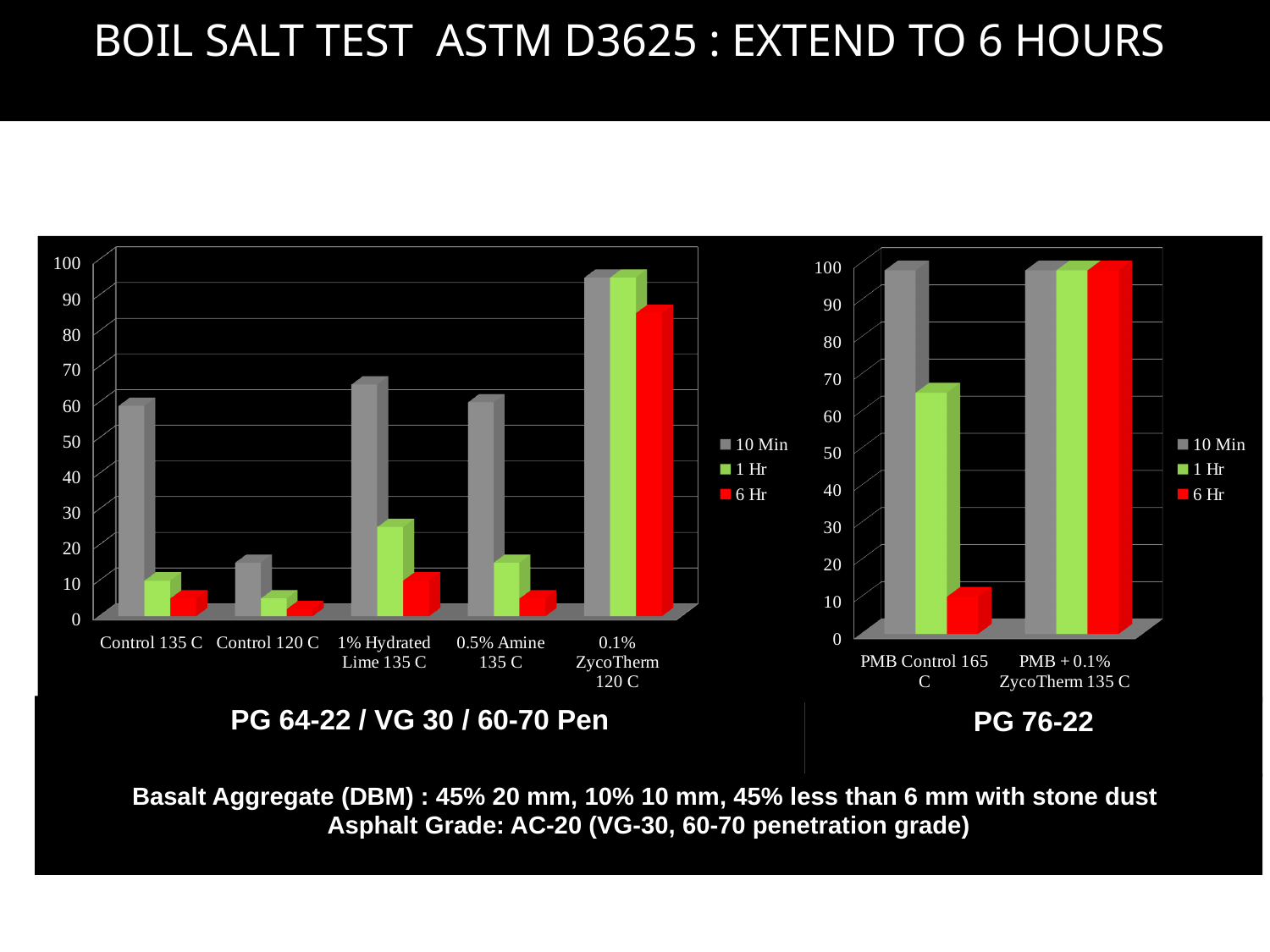
In the right chart (PG 76-22), which category has the larger 6 Hr value, PMB Control 165 C or PMB + 0.1% ZycoTherm 135 C? PMB + 0.1% ZycoTherm 135 C In the left chart (PG 64-22 / VG 30 / 60-70 Pen), is the 10 Min value for Control 135 C greater or less than 50? greater In the left chart (PG 64-22 / VG 30 / 60-70 Pen), which category has the lowest 10 Min value? Control 120 C In the left chart (PG 64-22 / VG 30 / 60-70 Pen), is the 6 Hr value for 1% Hydrated Lime 135 C greater or less than 20? less What kind of chart is the left chart (PG 64-22 / VG 30 / 60-70 Pen)? bar chart What are the legend entries of the right chart (PG 76-22)? 10 Min, 1 Hr, 6 Hr In the left chart (PG 64-22 / VG 30 / 60-70 Pen), which category has the highest 6 Hr value? 0.1% ZycoTherm 120 C In the right chart (PG 76-22), is the 1 Hr value for PMB Control 165 C greater or less than 50? greater How many series does the legend of the left chart (PG 64-22 / VG 30 / 60-70 Pen) list? 3 How many categories are shown on the x axis of the left chart (PG 64-22 / VG 30 / 60-70 Pen)? 5 How many categories are shown on the x axis of the right chart (PG 76-22)? 2